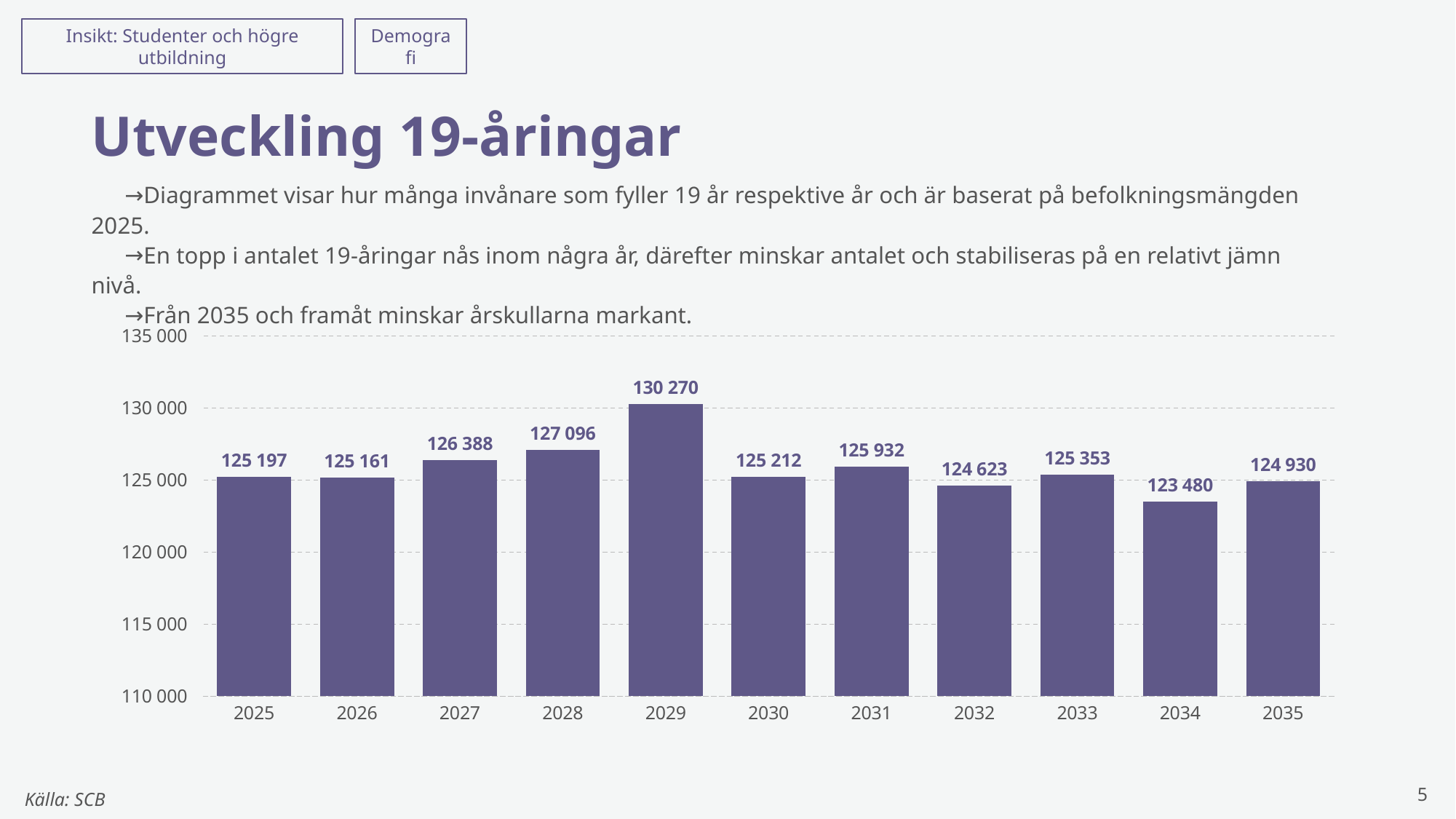
Which year has the highest value? 2029 Which is larger, the value for 2031 or the value for 2033? 2031 How many years are shown on the x axis? 11 What is the value for 2029? 130 270 Is the value for 2029 greater or less than 130 000? greater What is the value for 2034? 123 480 What kind of chart is shown on the slide? bar chart From 2026 to 2029, do the values rise or fall? rise What is the difference between the values for 2028 and 2027? 708 Which year has the lowest value? 2034 What is the difference between the values for 2029 and 2034? 6 790 What is the value for 2025? 125 197